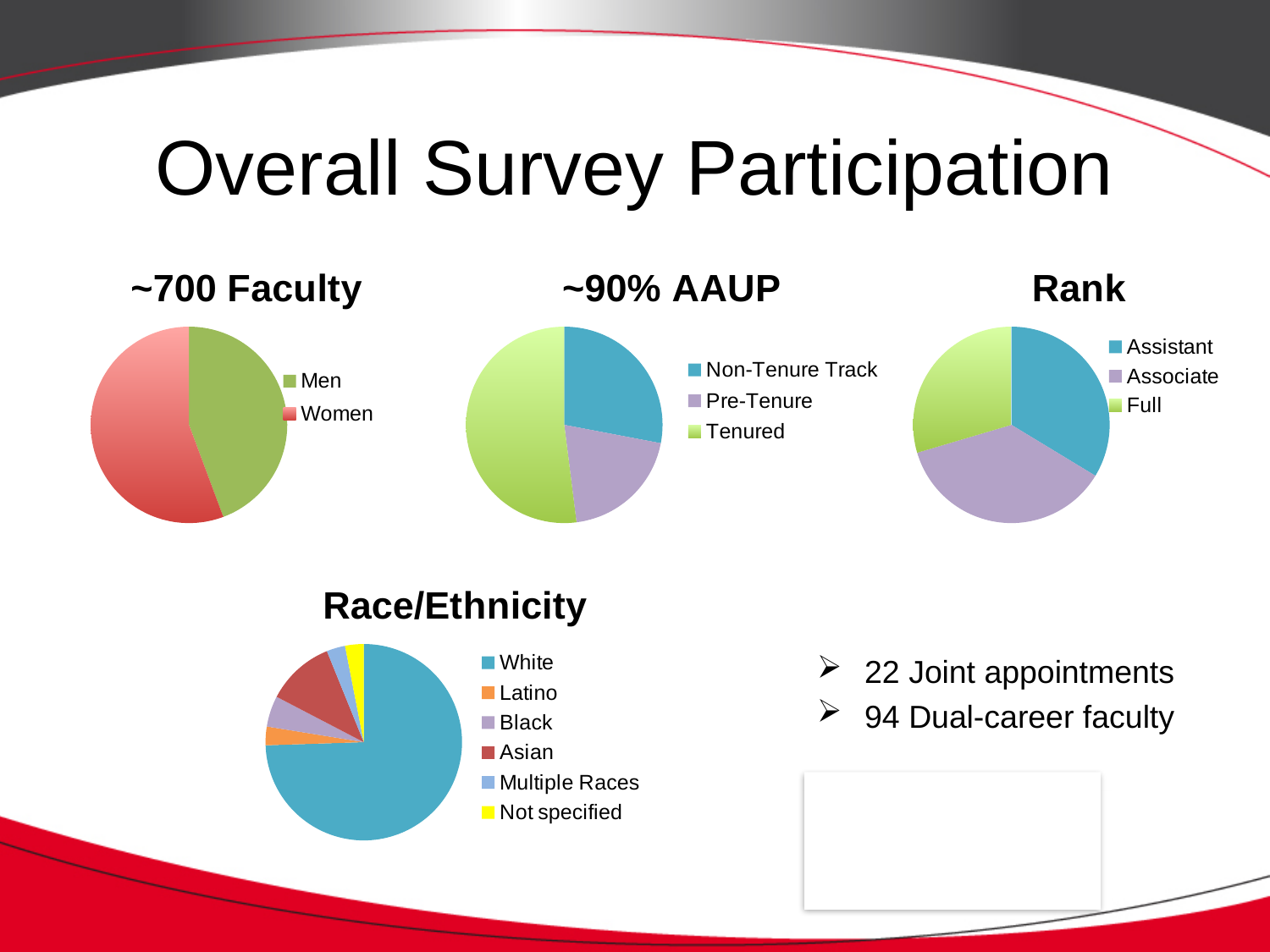
In the "~90% AAUP" chart, how many categories does the legend list? 3 In the "~700 Faculty" chart, how many categories does the legend list? 2 In the "Race/Ethnicity" chart, how many categories does the legend list? 6 In the "Race/Ethnicity" chart, which slice is larger, White or Asian? White In the "~700 Faculty" chart, what colour is the Women slice? red In the "Rank" chart, what are the three categories listed in the legend? Assistant, Associate, Full How many pie charts are shown on the slide? 4 In the "Race/Ethnicity" chart, which slice is larger, Asian or Black? Asian What kind of chart is the "Race/Ethnicity" chart? pie chart In the "Race/Ethnicity" chart, which category has the largest slice? White What is the title of the chart in the top-right of the slide? Rank In the "~90% AAUP" chart, which category has the largest slice? Tenured